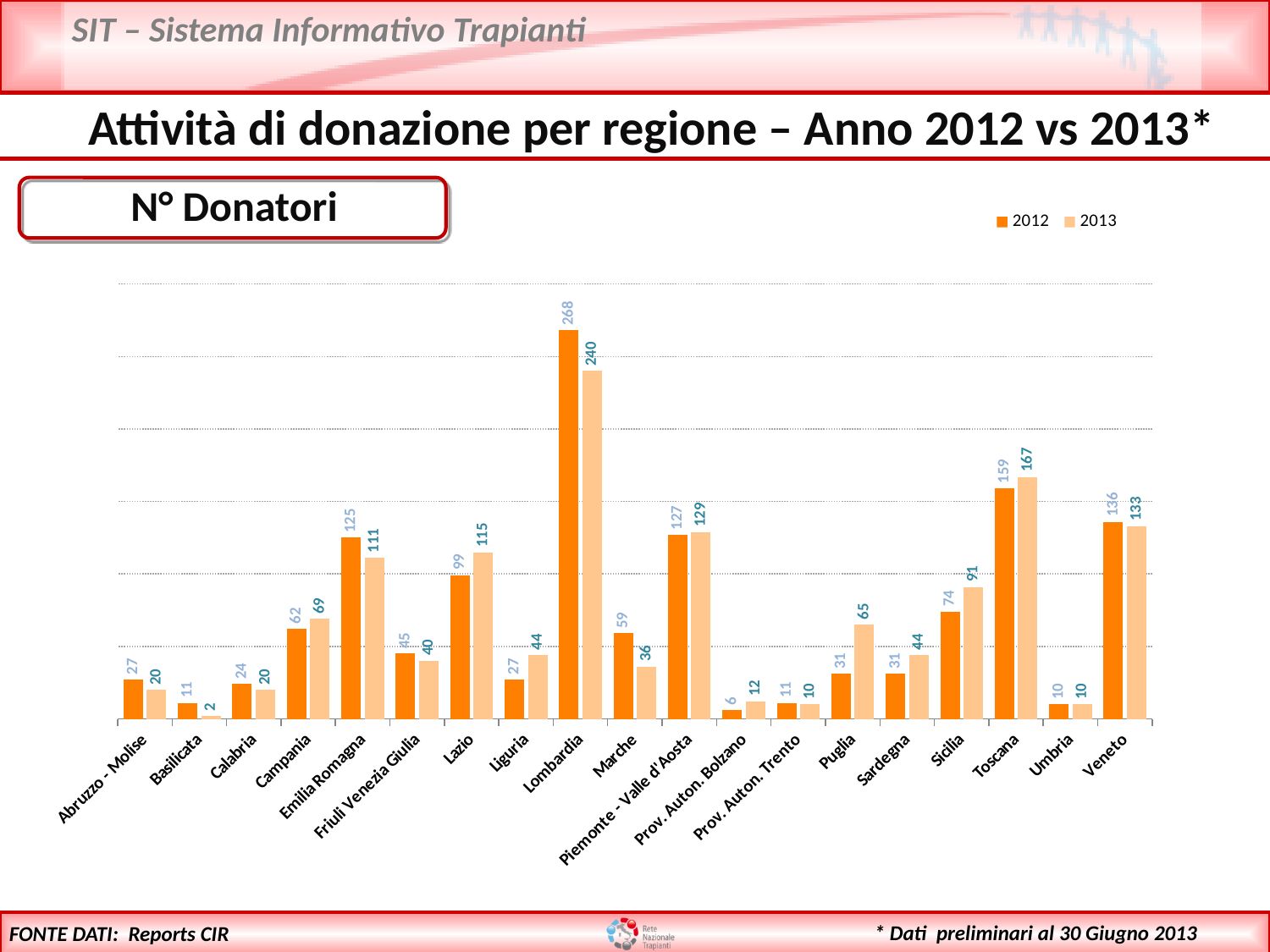
How many regions are shown on the x axis of the chart? 19 Which region has the lowest number of donors in 2013? Basilicata What is the difference between the 2012 and 2013 values for Lombardia? 28 Which is larger for Marche: the 2012 value or the 2013 value? 2012 What is the difference between the 2013 and 2012 values for Lazio? 16 How many series does the legend list? 2 What is the number of donors for Lombardia in 2012? 268 Which region has the highest number of donors in 2013? Lombardia What is the number of donors for Puglia in 2013? 65 What is the number of donors for Toscana in 2013? 167 Which is larger for Sicilia: the 2012 value or the 2013 value? 2013 What type of chart is shown on the slide? Bar chart